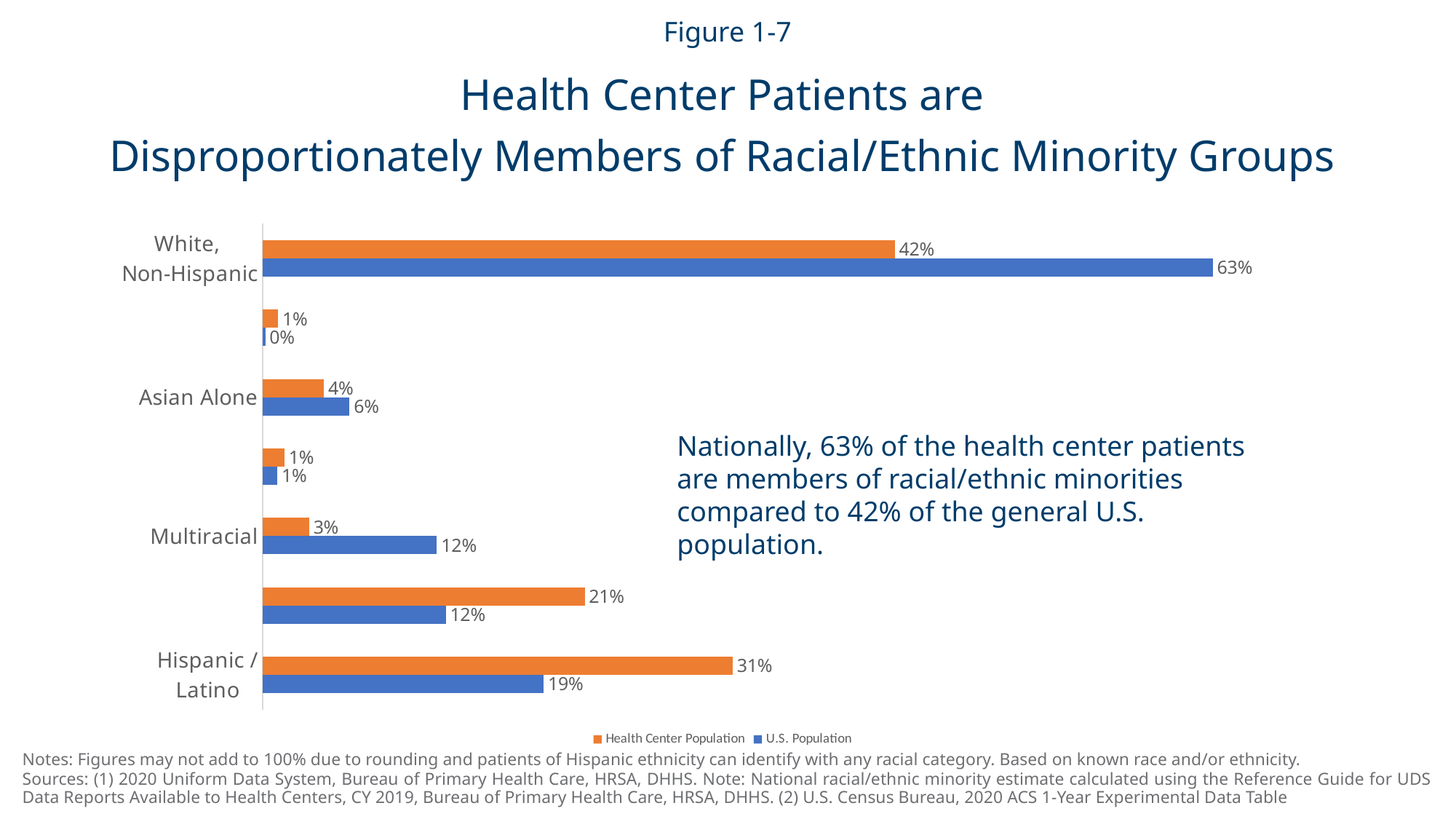
What is the U.S. Population value for Multiracial? 12% How many series does the legend list? 2 What is the Health Center Population value for White, Non-Hispanic? 42% What is the U.S. Population value for White, Non-Hispanic? 63% Which labeled category has the highest Health Center Population value? White, Non-Hispanic What kind of chart is shown on the slide? Bar chart What is the Health Center Population value for Asian Alone? 4% What is the Health Center Population value for Hispanic / Latino? 31% What is the difference between the U.S. Population and Health Center Population values for White, Non-Hispanic? 21% What is the difference between the Health Center Population and U.S. Population values for Hispanic / Latino? 12% For Hispanic / Latino, which is larger: the Health Center Population value or the U.S. Population value? Health Center Population For Multiracial, which is larger: the Health Center Population value or the U.S. Population value? U.S. Population